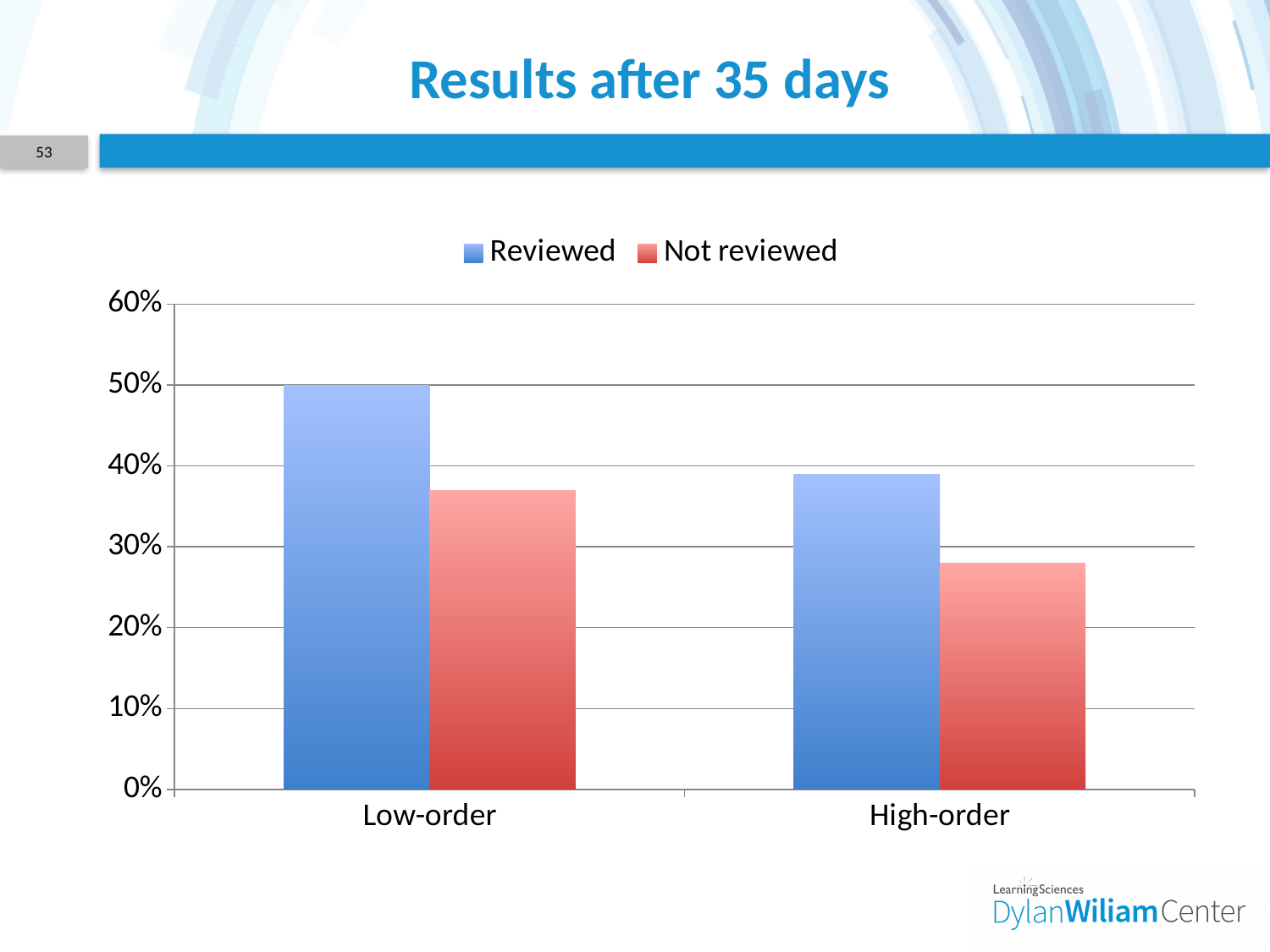
What is the value for Reviewed in the Low-order category? 50% Which bar is the highest in the chart? Reviewed, Low-order What is the title of the chart? Results after 35 days In the High-order category, which is larger: Reviewed or Not reviewed? Reviewed Which bar is the lowest in the chart? Not reviewed, High-order How many series does the legend list? 2 Does the Reviewed series rise or fall from Low-order to High-order? Fall Is the value for Not reviewed in the Low-order category greater or less than 40%? less What kind of chart is shown on the slide? Bar chart Is the value for Not reviewed in the High-order category greater or less than 30%? less How many categories are shown on the x axis? 2 In the Low-order category, which is larger: Reviewed or Not reviewed? Reviewed